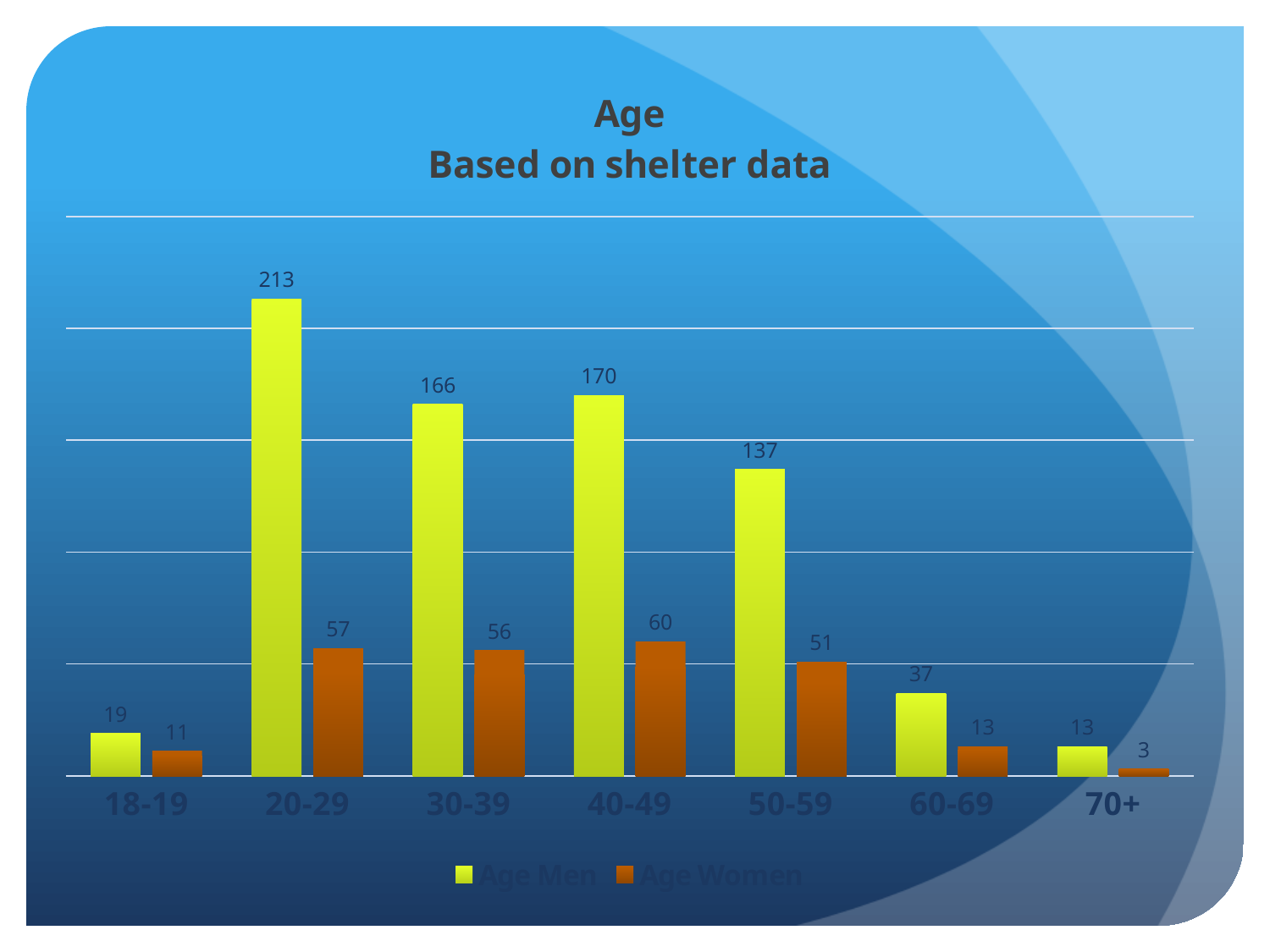
What is the value for Age Women in the 40-49 category? 60 Which age category has the lowest value for Age Women? 70+ What is the value for Age Men in the 70+ category? 13 Do the Age Women values rise or fall from 40-49 to 70+? Fall Which is larger, Age Men for 30-39 or Age Men for 40-49? Age Men for 40-49 What is the value for Age Men in the 20-29 category? 213 Which age category has the highest value for Age Men? 20-29 What is the difference between Age Men and Age Women in the 50-59 category? 86 How many age categories are shown on the x axis? 7 What is the title of the chart? Age Based on shelter data How many series does the legend list? 2 What kind of chart is shown on the slide? Bar chart